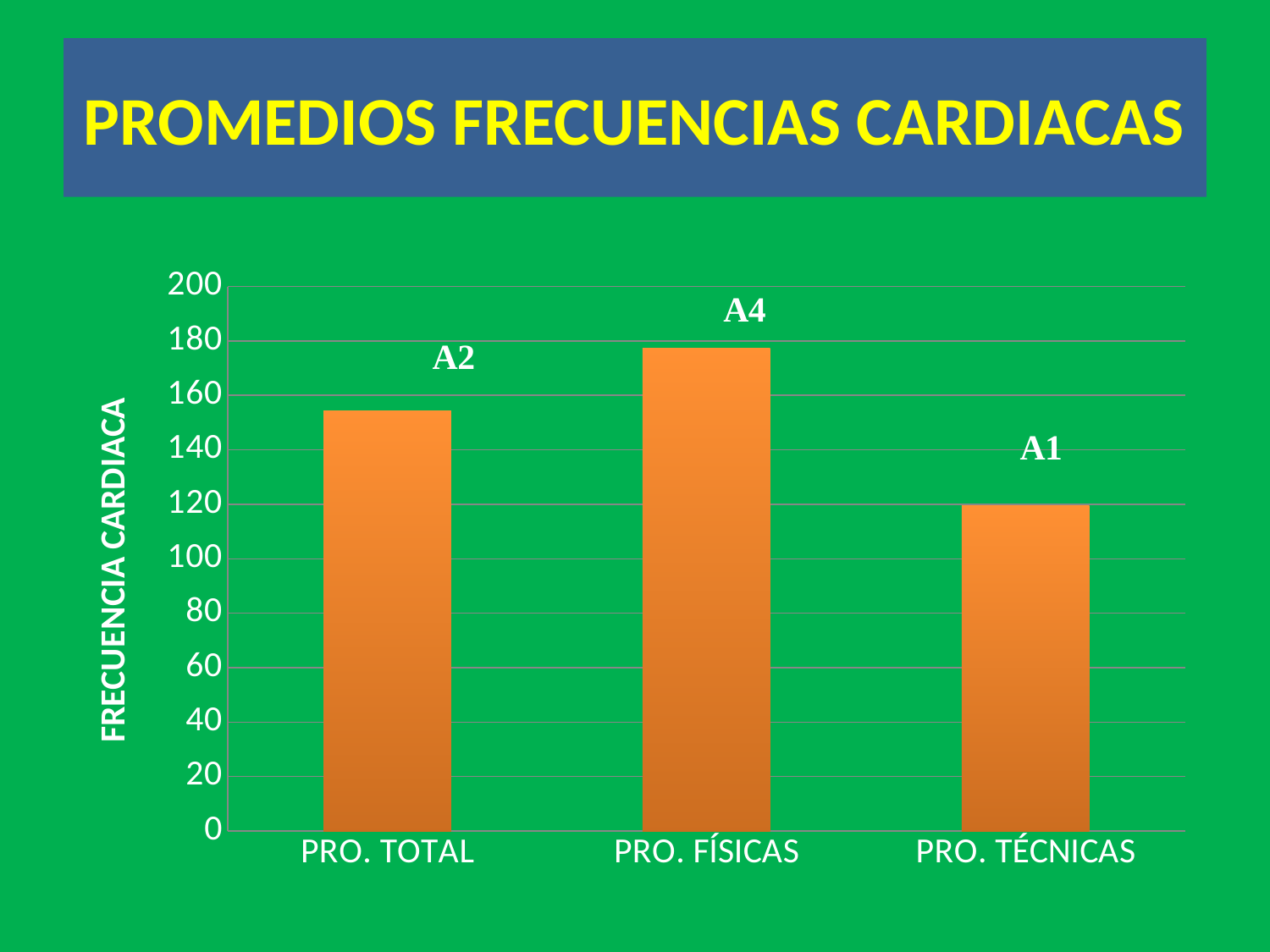
What is the title of the vertical axis of the chart? FRECUENCIA CARDIACA What label is printed above the PRO. FÍSICAS bar? A4 Is the value for PRO. TOTAL greater or less than 140? greater Is the value for PRO. FÍSICAS greater or less than 160? greater Is the value for PRO. FÍSICAS greater or less than 180? less Which category has the lowest value in the chart? PRO. TÉCNICAS How many categories are plotted on the x axis of the chart? 3 Which category has the highest value in the chart? PRO. FÍSICAS What kind of chart is shown on the slide? bar chart Which is larger, the value for PRO. TOTAL or the value for PRO. TÉCNICAS? PRO. TOTAL